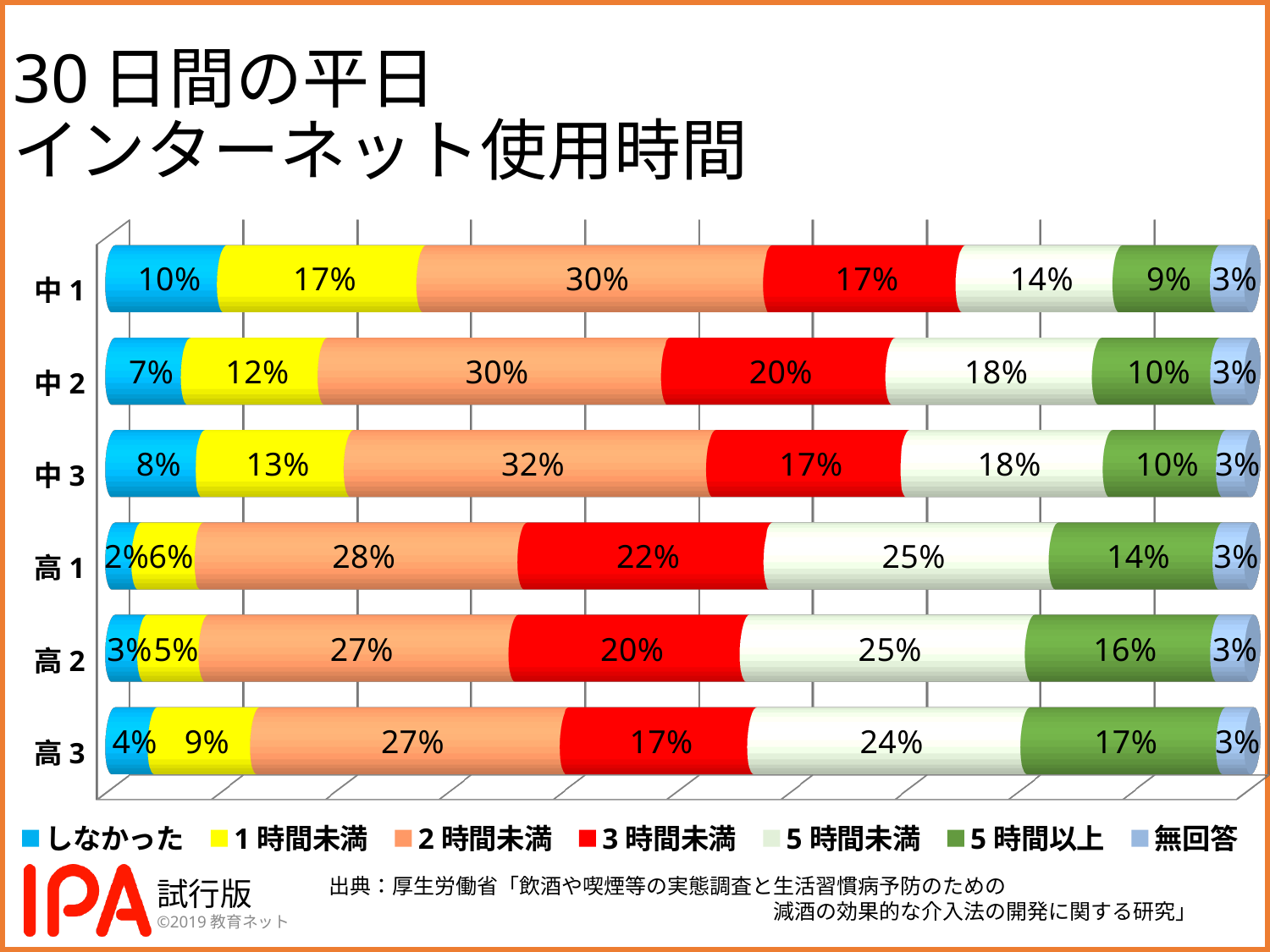
Which grade has the lowest value for しなかった? 高1 What percentage of 中1 students used the internet for 2時間未満? 30% What is the value for 5時間以上 in the 高3 bar? 17% Which colour represents 無回答 in the legend? Light blue What is the difference between the 3時間未満 values for 高1 and 高3? 5% What kind of chart is shown on the slide? Stacked bar chart Which grade has the highest value for 5時間未満? 高1 and 高2 (25%) How many grade categories are shown on the chart? 6 Does the value for しなかった rise or fall from 中1 to 高1? Fall What percentage of 高1 students answered しなかった? 2% Which is larger: the 1時間未満 value for 中1 or for 中3? 中1 How many series does the legend list? 7